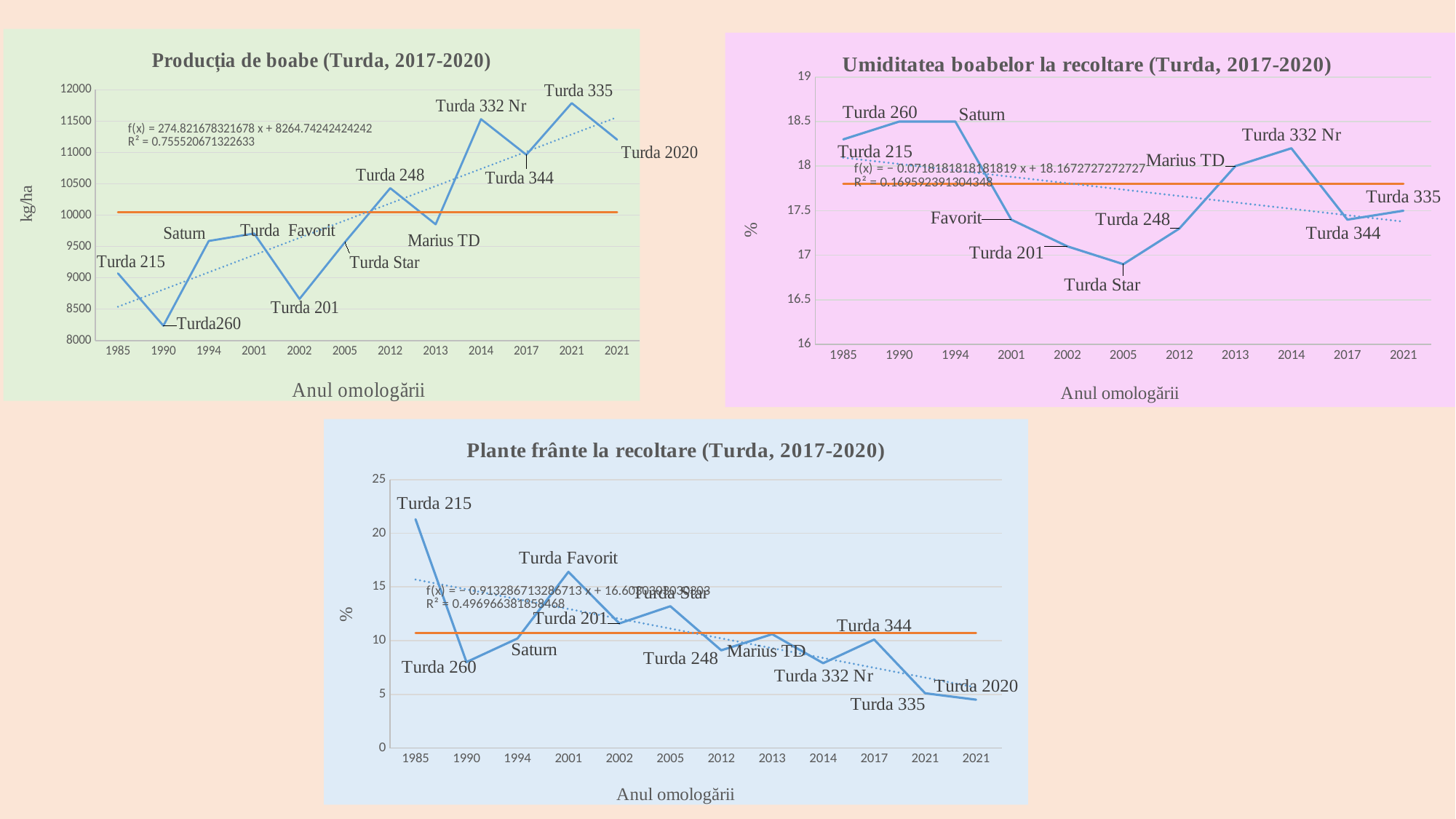
In the chart "Producția de boabe (Turda, 2017-2020)", which hybrid has the highest grain yield? Turda 335 In the chart "Producția de boabe (Turda, 2017-2020)", which hybrid has the lowest grain yield? Turda 260 What kind of chart is "Producția de boabe (Turda, 2017-2020)"? line chart In the chart "Plante frânte la recoltare (Turda, 2017-2020)", do the values generally rise or fall along the x axis? fall What unit is shown on the vertical axis of the chart "Producția de boabe (Turda, 2017-2020)"? kg/ha In the chart "Plante frânte la recoltare (Turda, 2017-2020)", which hybrid has the highest value? Turda 215 In the chart "Umiditatea boabelor la recoltare (Turda, 2017-2020)", which hybrid has the lowest grain moisture? Turda Star In the chart "Producția de boabe (Turda, 2017-2020)", is the value for Turda 335 greater or less than 11500? greater In the chart "Producția de boabe (Turda, 2017-2020)", is the value for Turda 260 greater or less than 8500? less How many data points are plotted in the chart "Producția de boabe (Turda, 2017-2020)"? 12 In the chart "Plante frânte la recoltare (Turda, 2017-2020)", is the value for Turda Favorit greater or less than 15? greater